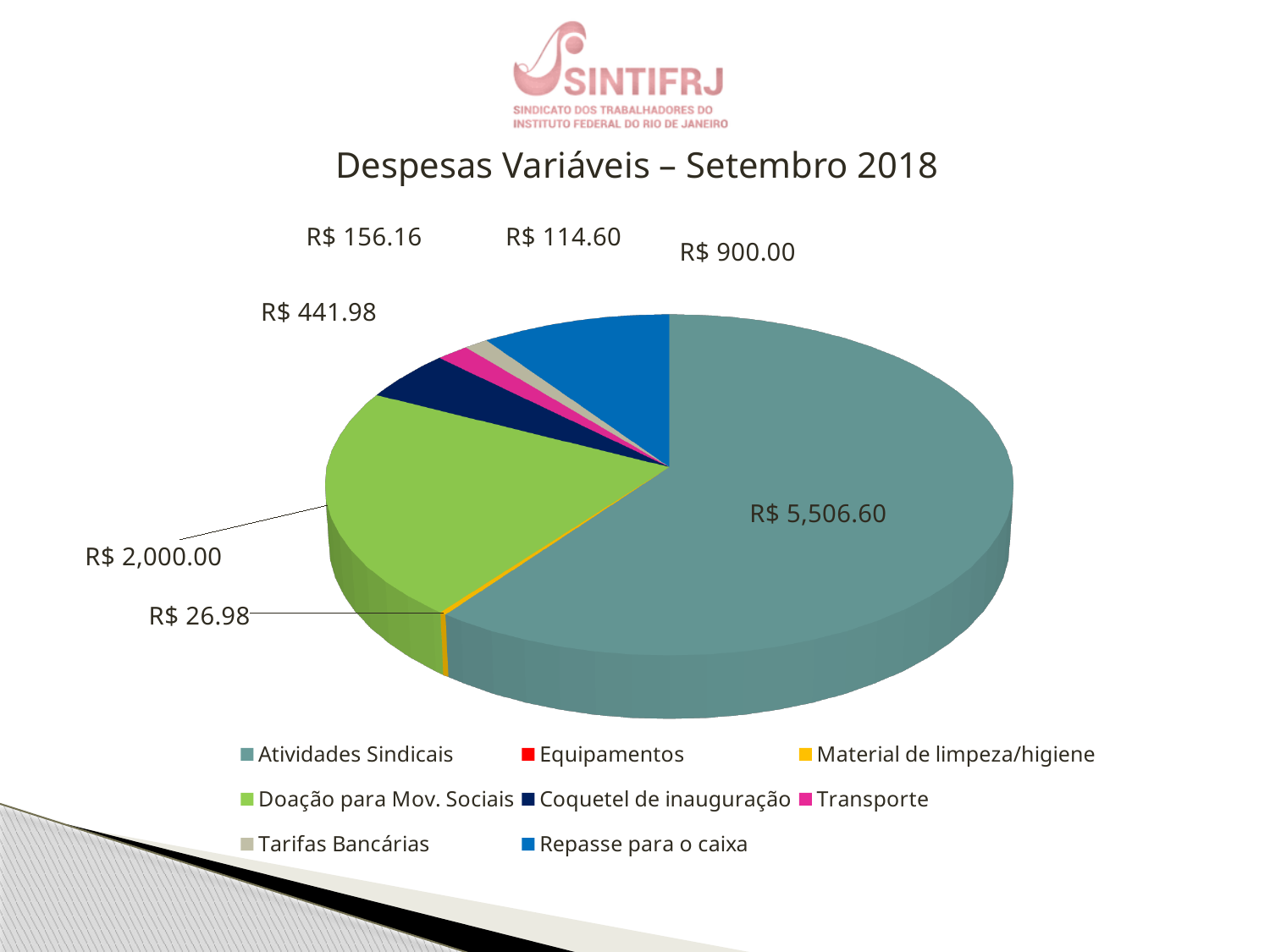
Which is larger, Doação para Mov. Sociais or Repasse para o caixa? Doação para Mov. Sociais What is the value for Repasse para o caixa? R$ 900.00 What is the title of the chart? Despesas Variáveis – Setembro 2018 What is the difference between Atividades Sindicais and Doação para Mov. Sociais? R$ 3,506.60 What is the value for Material de limpeza/higiene? R$ 26.98 What colour is the slice for Atividades Sindicais? Teal What is the value for Doação para Mov. Sociais? R$ 2,000.00 How many entries does the chart legend list? 8 What is the value for Coquetel de inauguração? R$ 441.98 Which category has the largest slice of the pie? Atividades Sindicais What kind of chart is shown on the slide? Pie chart What is the value for Atividades Sindicais? R$ 5,506.60